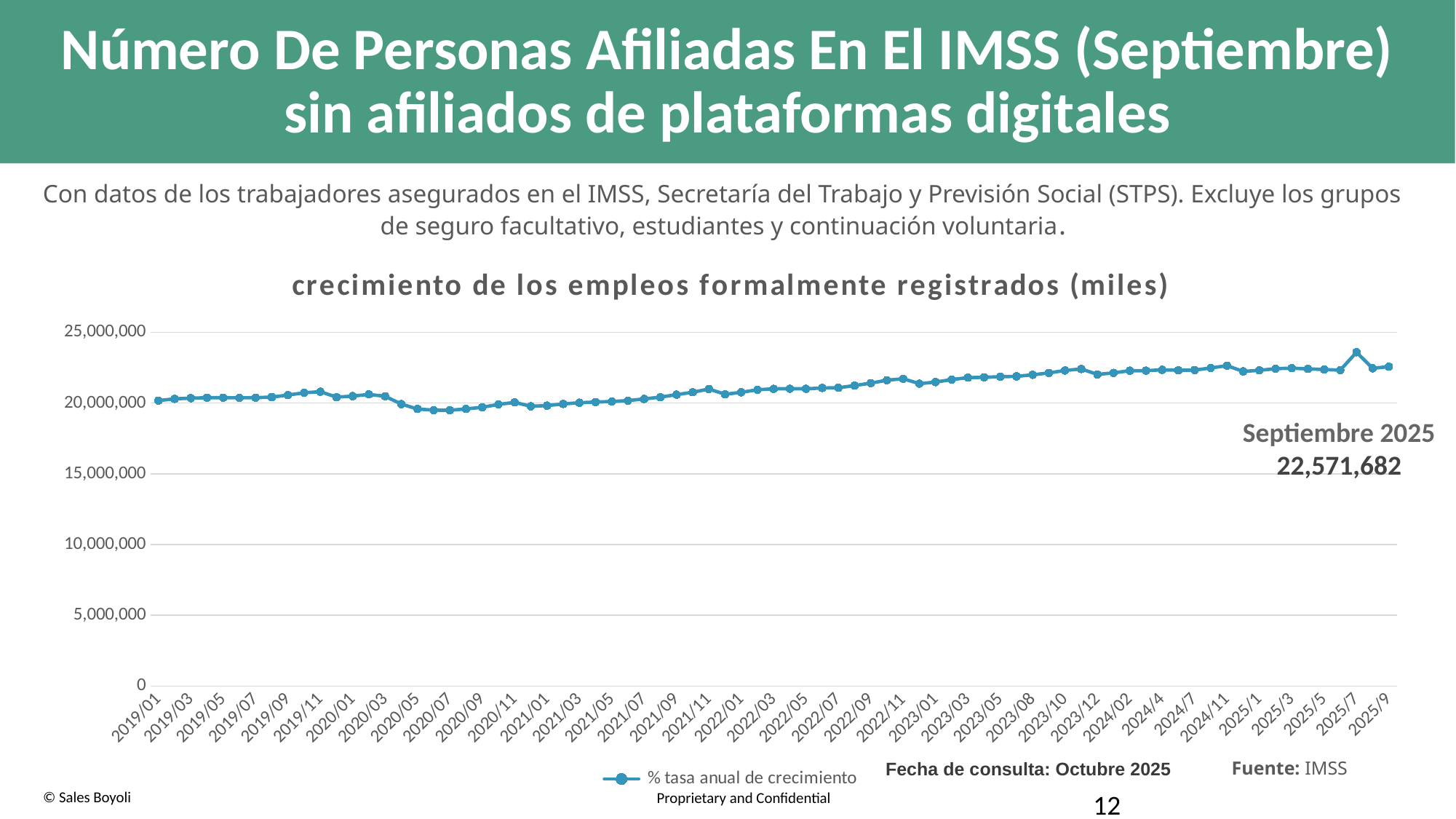
Is the value for 2025/9 greater or less than 25,000,000? less Is the value for 2025/7 greater or less than 20,000,000? greater How many series does the chart legend list? 1 Is the value for 2023/01 greater or less than 20,000,000? greater What is the title of the chart? crecimiento de los empleos formalmente registrados (miles) Which point on the x axis has the highest value? 2025/7 What is the legend entry for the plotted series? % tasa anual de crecimiento What value is shown for Septiembre 2025? 22,571,682 Overall, do the values rise or fall from 2019/01 to 2025/9? rise What kind of chart is shown on the slide? line chart Which is larger, the value for 2020/07 or the value for 2025/7? 2025/7